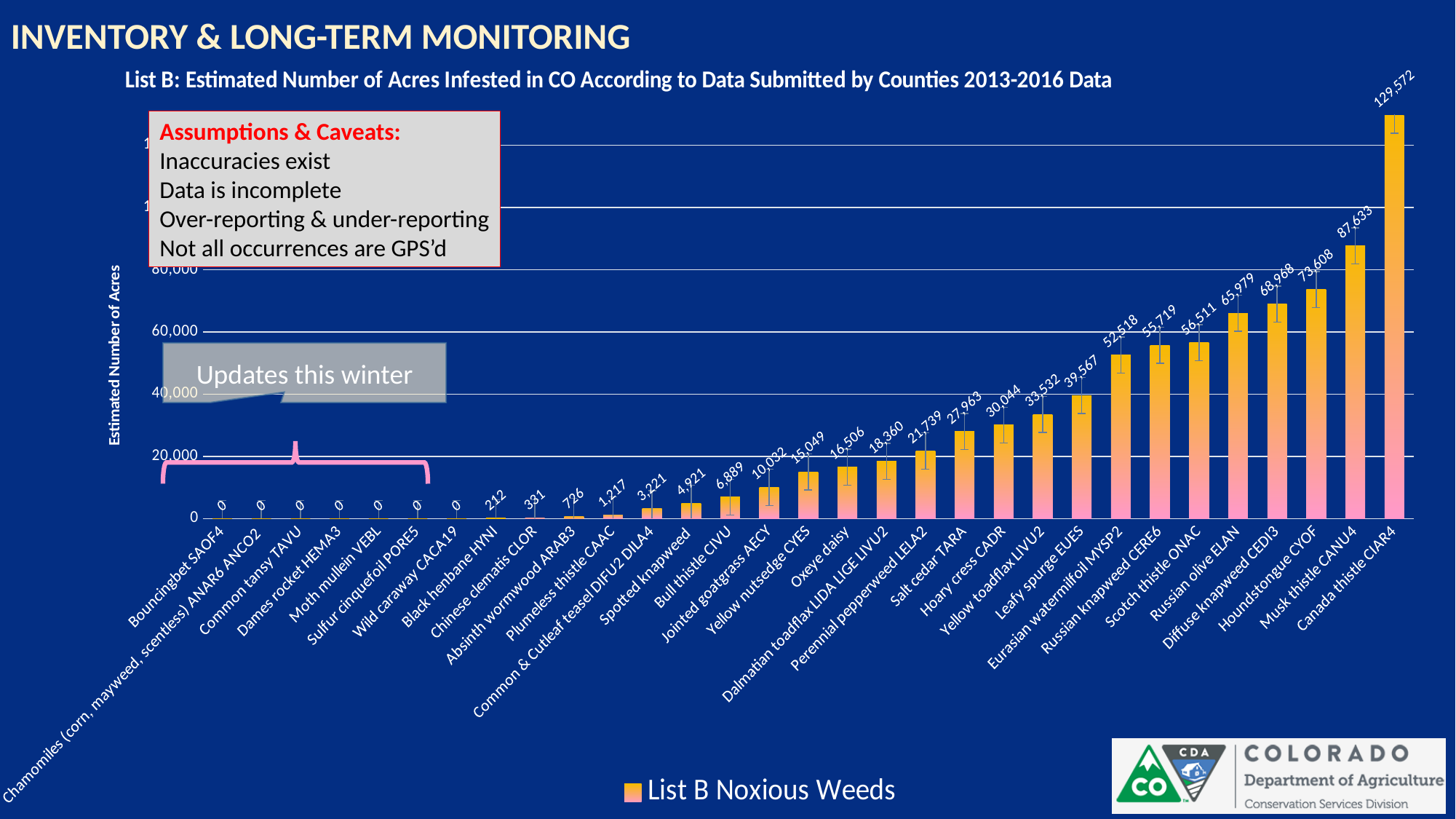
Which has more estimated acres infested, Salt cedar TARA or Hoary cress CADR? Hoary cress CADR What type of chart is shown on the slide? Bar chart What is the estimated number of acres infested for Leafy spurge EUES? 39,567 What is the estimated number of acres infested for Canada thistle CIAR4? 129,572 What is the estimated number of acres infested for Black henbane HYNI? 212 What is the difference in estimated acres between Canada thistle CIAR4 and Musk thistle CANU4? 41,939 Do the values rise or fall moving from left to right along the x axis? Rise What is the difference in estimated acres between Russian knapweed CERE6 and Eurasian watermilfoil MYSP2? 3,201 How many series does the chart legend list? 1 Which weed has the highest estimated number of acres infested? Canada thistle CIAR4 Which has more estimated acres infested, Houndstongue CYOF or Diffuse knapweed CEDI3? Houndstongue CYOF How many weed categories are shown on the x axis of the chart? 31